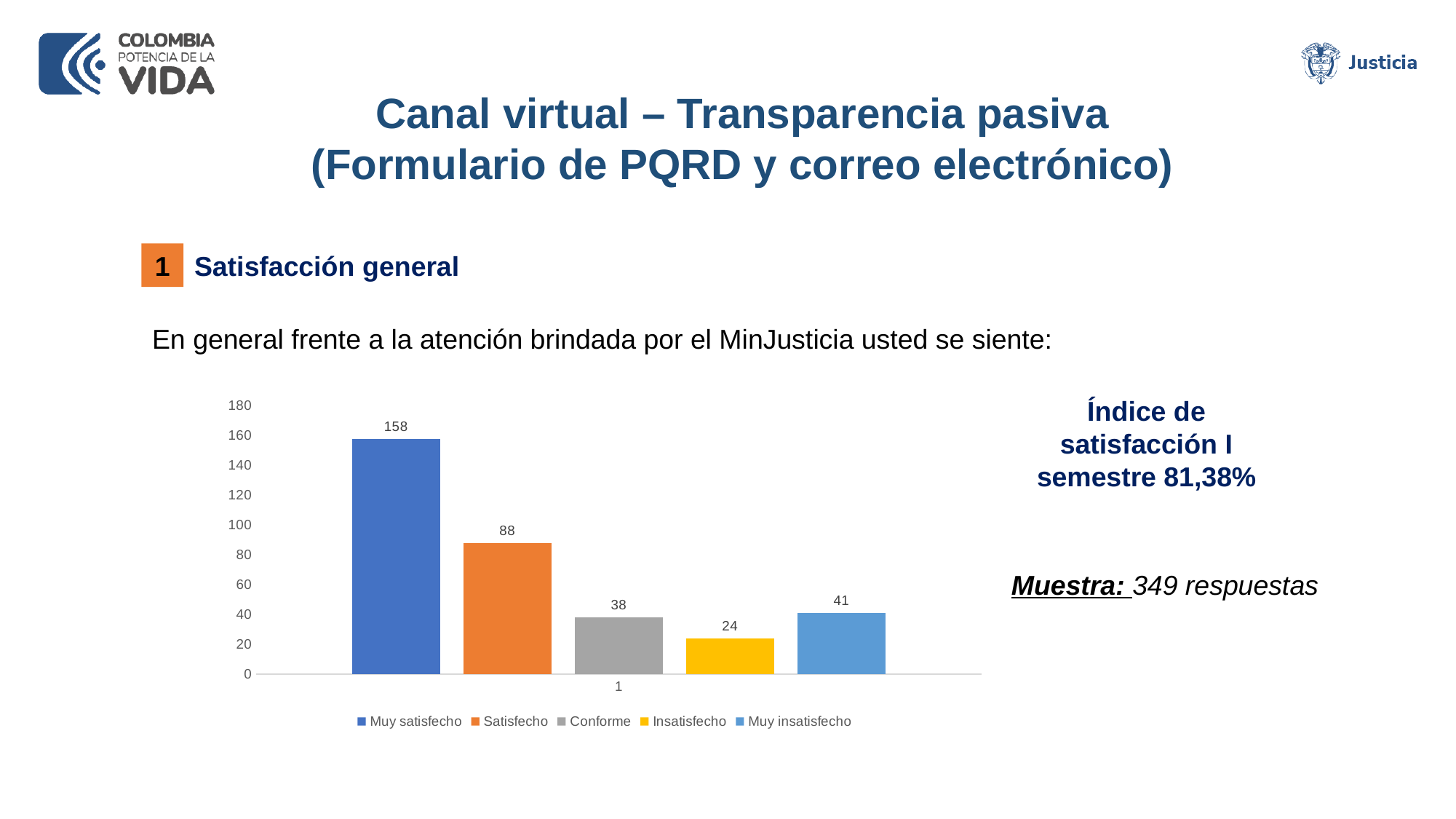
What is the value for Insatisfecho? 24 What is the value for Satisfecho? 88 Which series has the lowest value? Insatisfecho What is the difference between the values for Muy satisfecho and Satisfecho? 70 What is the value for Conforme? 38 Which series has the highest value? Muy satisfecho What colour is the bar for Insatisfecho? Yellow How many series does the legend list? 5 What is the value for Muy insatisfecho? 41 What is the value for Muy satisfecho? 158 What kind of chart is shown on the slide? Bar chart Which is larger, the value for Conforme or the value for Muy insatisfecho? Muy insatisfecho